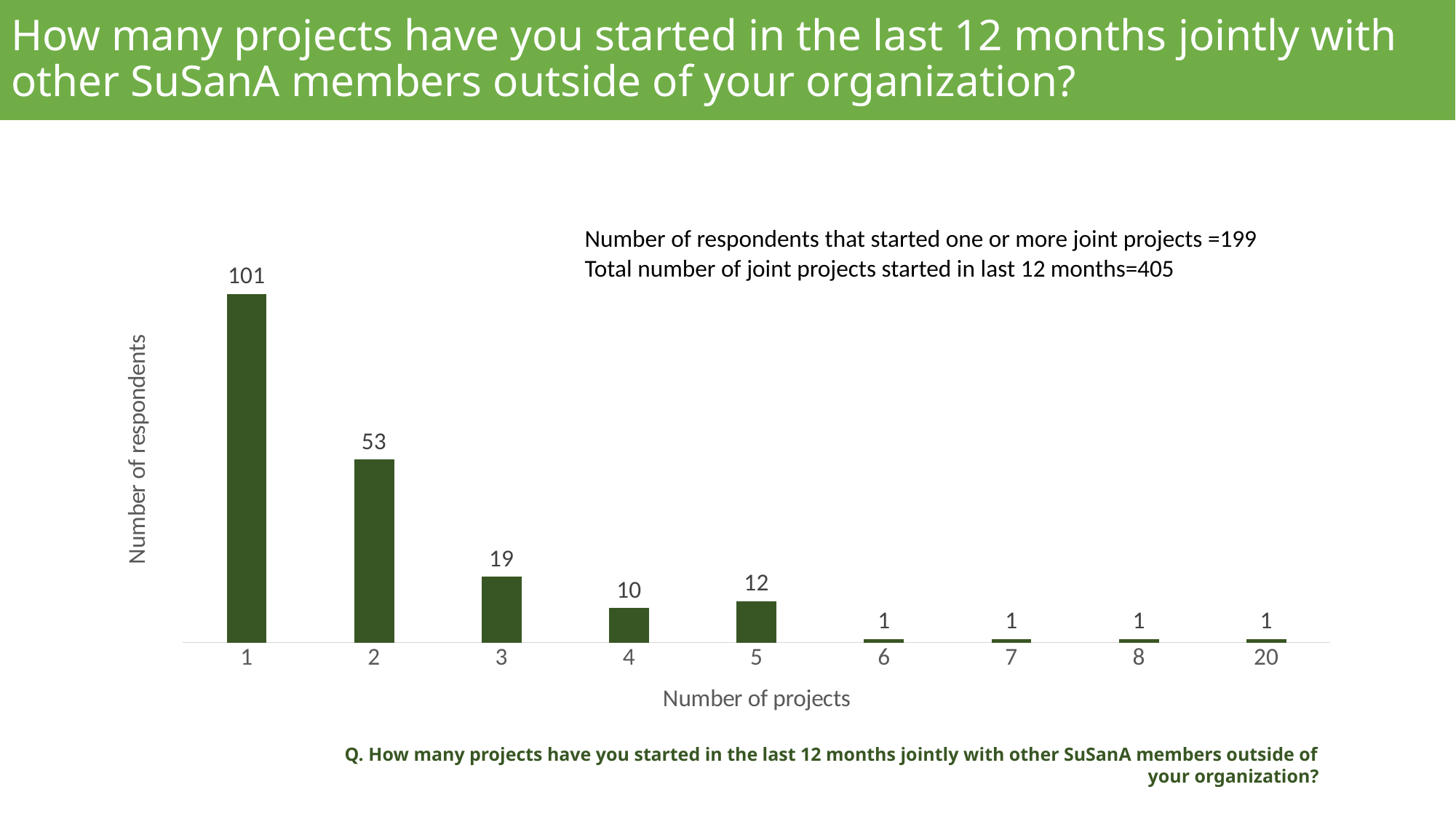
How many categories are shown on the x axis? 9 Which number of projects has the highest number of respondents? 1 How many respondents started 1 joint project? 101 What is the label of the y axis? Number of respondents How many respondents started 20 joint projects? 1 What is the difference in respondents between 1 project and 2 projects? 48 Which has more respondents: 4 projects or 5 projects? 5 projects How many respondents started 2 joint projects? 53 What kind of chart is shown on the slide? Bar chart How many respondents started 5 joint projects? 12 What is the label of the x axis? Number of projects What is the difference in respondents between 3 projects and 4 projects? 9